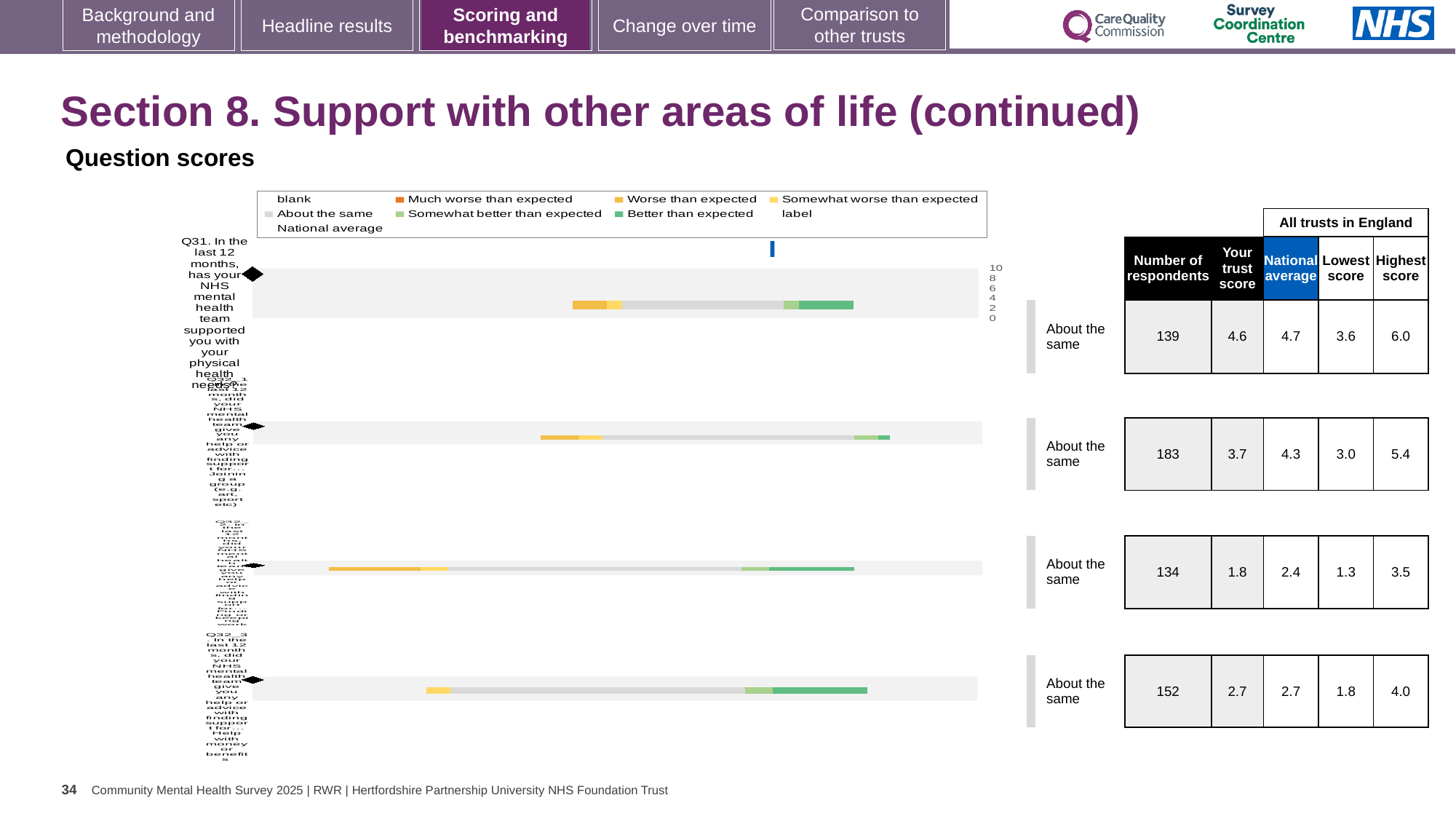
Which question row has the lowest 'Your trust score'? Q32_2 (third row) Which question row has the highest 'Your trust score'? Q31 How many question bars are plotted in the chart? 4 What is the highest score among all trusts in England for the fourth question row (Q32_3)? 4.0 How many entries does the chart legend list? 9 What is the national average for the second question row (Q32_1)? 4.3 What kind of chart is shown on the slide? bar chart For Q31, which is larger: the trust score or the national average? National average How many respondents are listed for Q31 (support with physical health needs)? 139 What is the 'Your trust score' for Q31 (support with physical health needs)? 4.6 Which benchmark category is shown next to every bar in the chart? About the same What is the difference between the national average and the trust score for the second question row (Q32_1)? 0.6